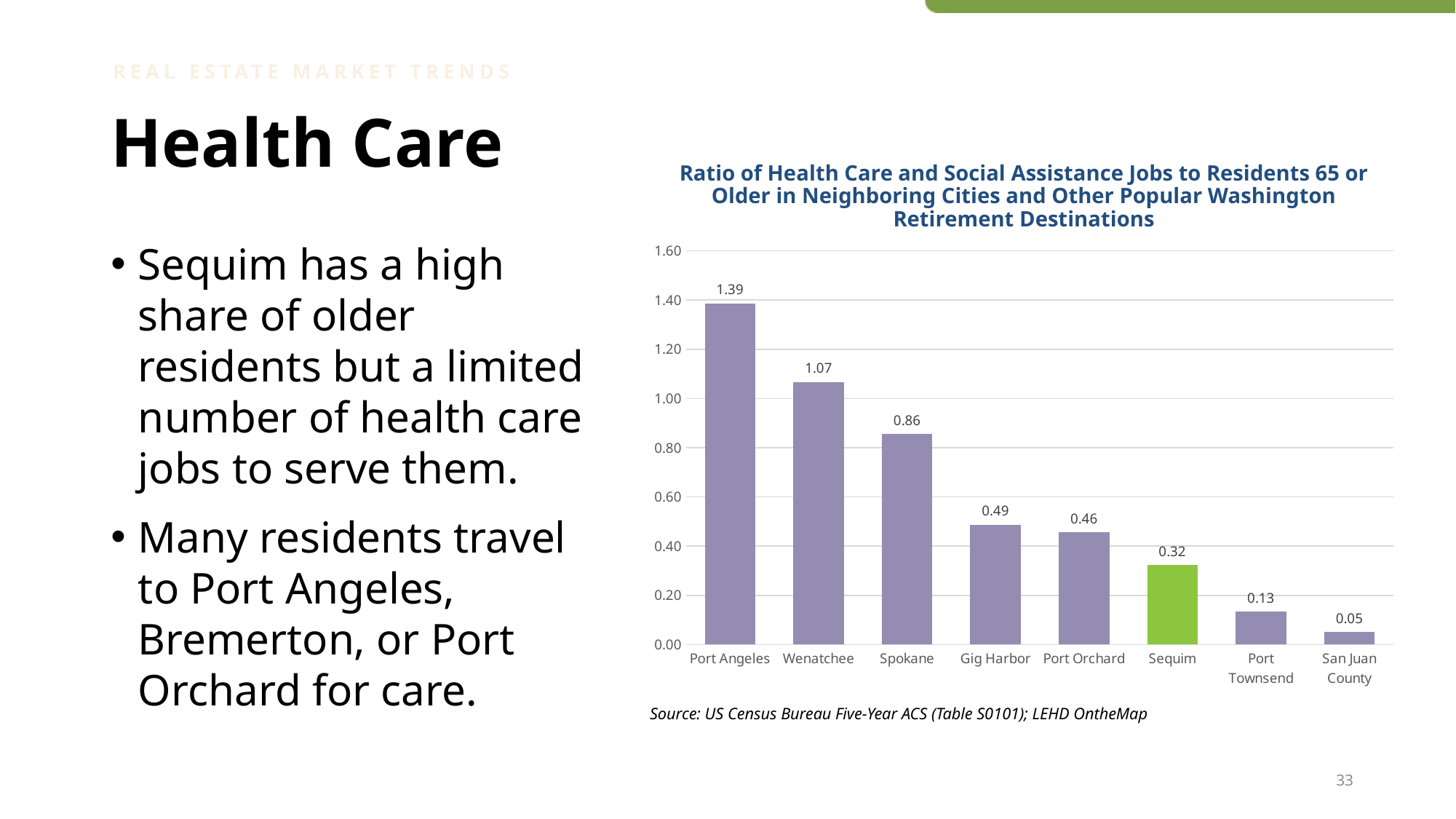
What is the difference between the values for Wenatchee and Spokane? 0.21 Is the value for Spokane greater or less than 1.00? less What is the value shown for Port Angeles? 1.39 Which bar in the chart is coloured green rather than purple? Sequim What is the value shown for Port Townsend? 0.13 Which has a higher ratio, Gig Harbor or Port Orchard? Gig Harbor Which location has the lowest ratio in the chart? San Juan County What is the ratio of health care and social assistance jobs to residents 65 or older for Sequim? 0.32 Which city has the highest ratio in the chart? Port Angeles What is the difference between the values for Port Angeles and Sequim? 1.07 How many cities or locations are shown in the chart? 8 What kind of chart is shown on the slide? Bar chart